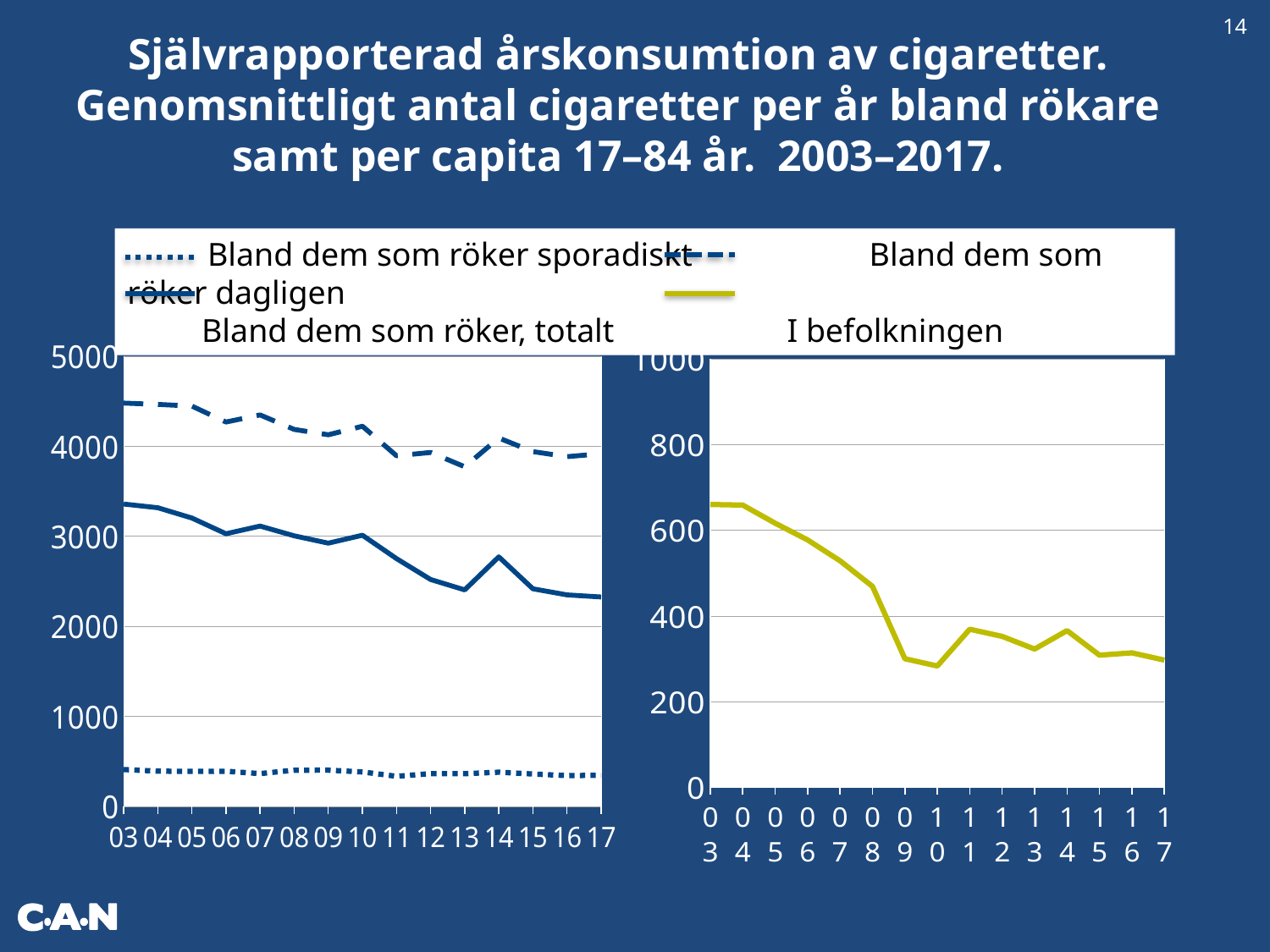
How many series does the legend list? 4 In the left chart, does the line for 'Bland dem som röker dagligen' rise or fall from 03 to 17? fall In the left chart, which is larger in 17: 'Bland dem som röker dagligen' or 'Bland dem som röker, totalt'? Bland dem som röker dagligen What kind of chart is the left chart on the slide? line chart In the left chart, is the value for 'Bland dem som röker dagligen' in 03 greater or less than 4000? greater How many years are plotted on the x axis of the left chart? 15 In the left chart, is the value for 'Bland dem som röker sporadiskt' in 10 greater or less than 1000? less Which series in the legend is drawn with a dotted line? Bland dem som röker sporadiskt In the right chart ('I befolkningen'), does the line overall rise or fall from 03 to 17? fall In the right chart ('I befolkningen'), is the value for 03 greater or less than 600? greater